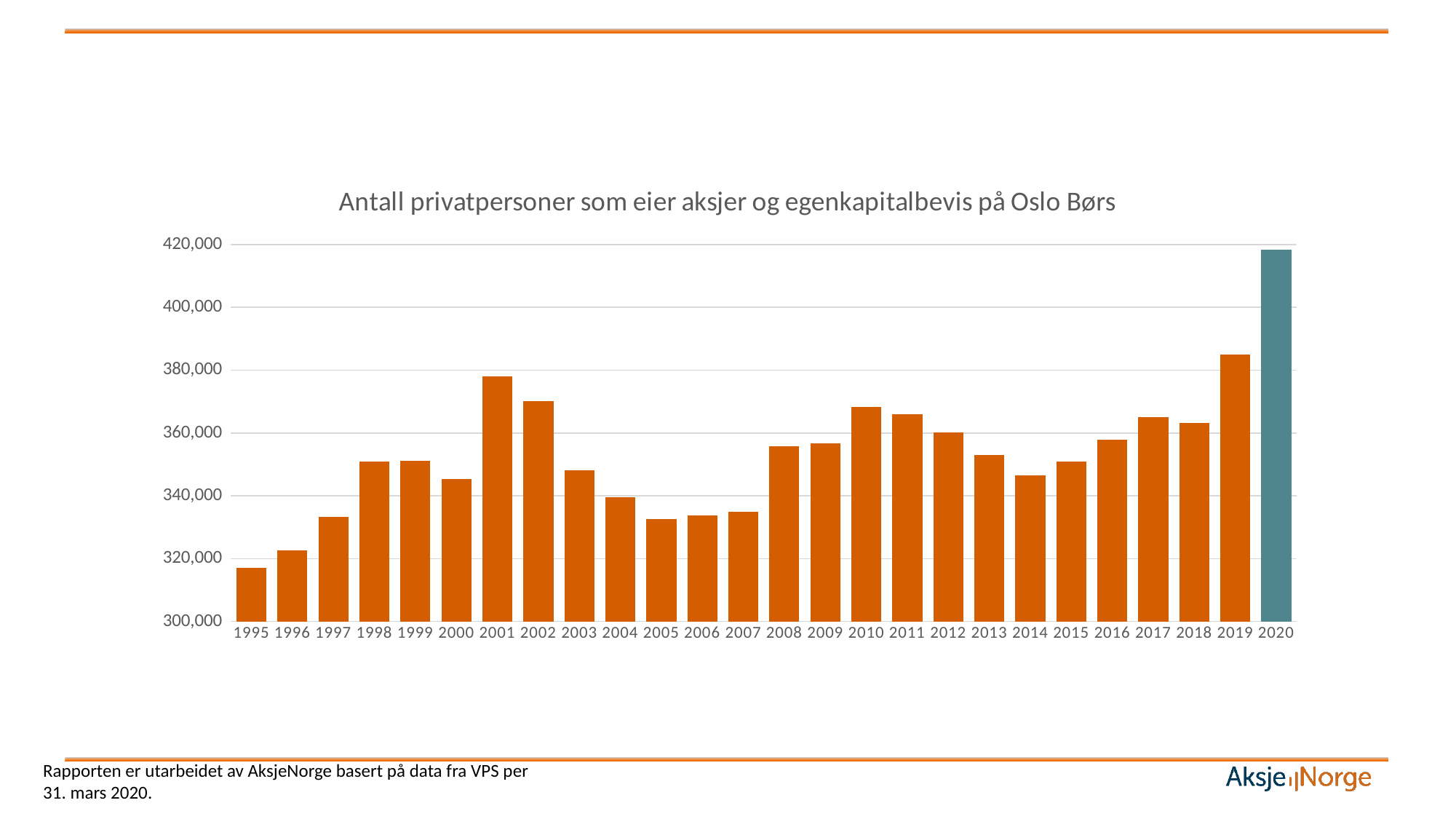
Which year has the larger value, 2001 or 2002? 2001 Which year has the highest value in the chart? 2020 What is the title of the chart? Antall privatpersoner som eier aksjer og egenkapitalbevis på Oslo Børs Do the values rise or fall from 1995 to 1999? rise Which year has the lowest value in the chart? 1995 How many years are shown on the x axis of the chart? 26 Is the value for 2001 greater or less than 360,000? greater Is the value for 2005 greater or less than 340,000? less What type of chart is shown on the slide? Bar chart Is the value for 2014 greater or less than 360,000? less Which year has the larger value, 2010 or 2019? 2019